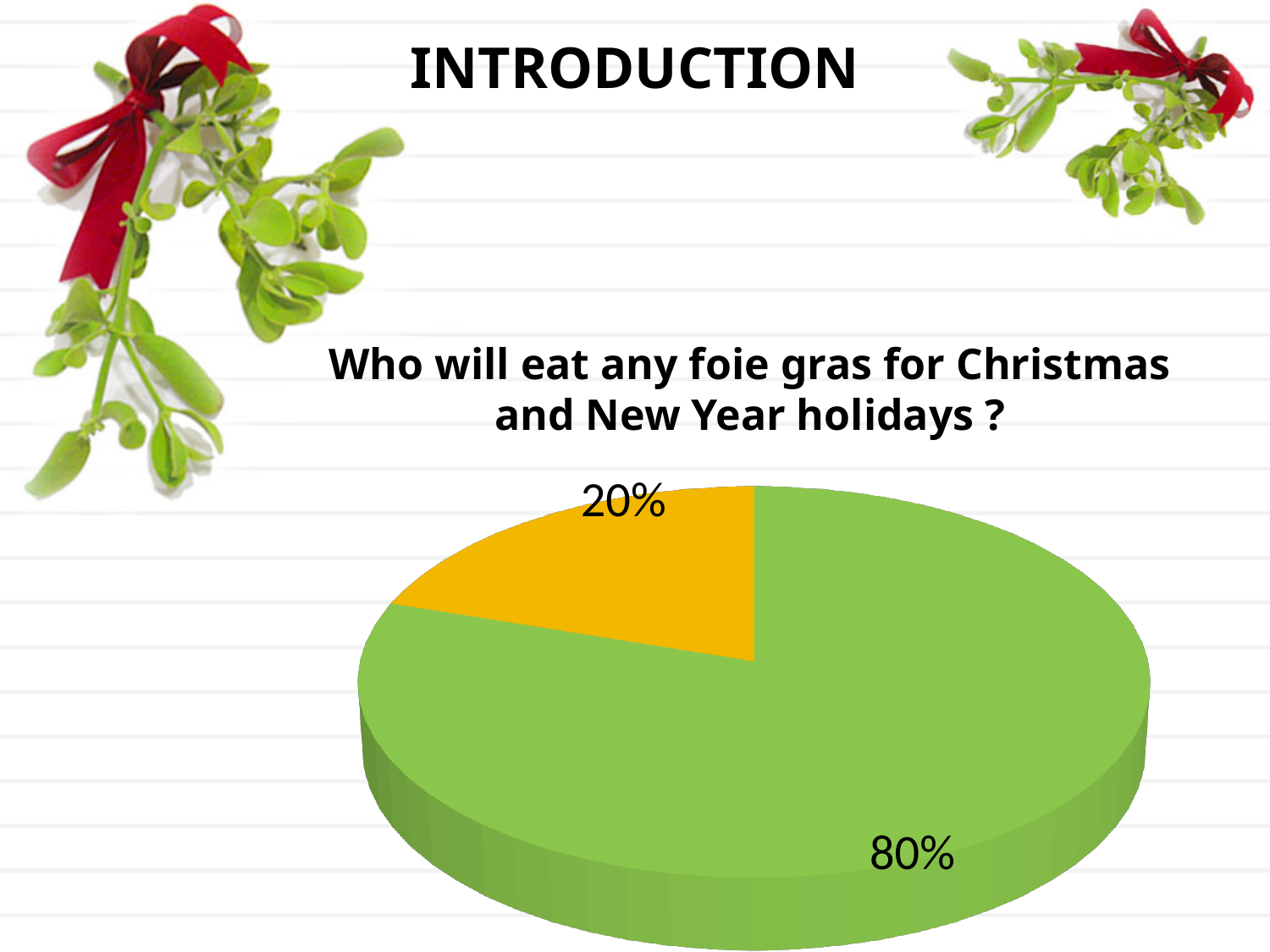
What is the difference in percentage points between the green slice and the orange slice? 60 What is the title of the pie chart? Who will eat any foie gras for Christmas and New Year holidays ? How many slices does the pie chart have? 2 Which slice of the pie chart is the smallest, the green one or the orange one? the orange one What percentage is shown for the green slice of the pie chart? 80% What colour is the largest slice of the pie chart? green What share of the pie does the orange slice represent? 20% What do the two slices of the pie chart add up to? 100% What kind of chart is shown on the slide? pie chart Is the green slice larger or smaller than the orange slice? larger Which slice of the pie chart is the largest, the green one or the orange one? the green one What percentage is shown for the orange slice of the pie chart? 20%